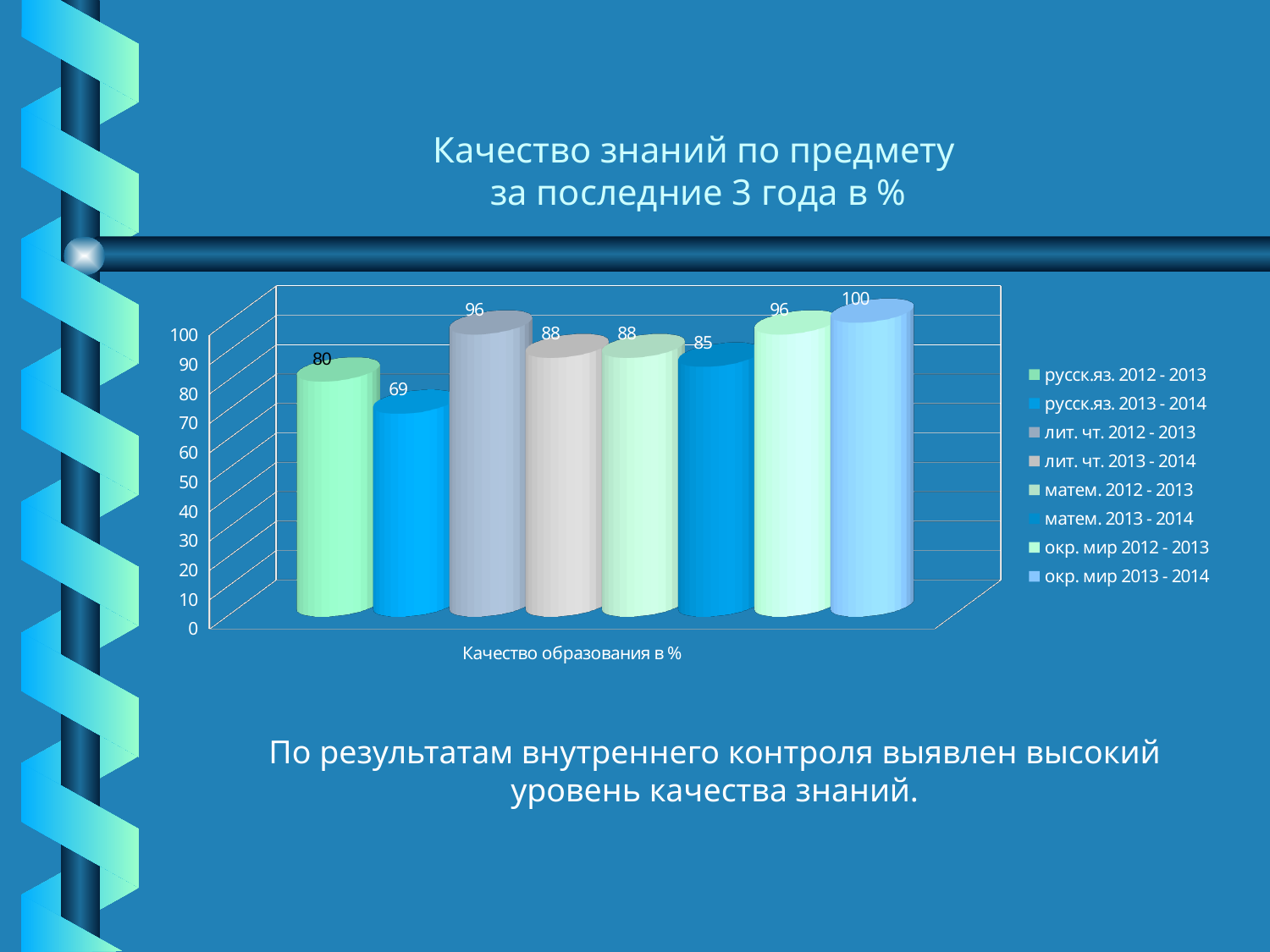
What is the value for окр. мир 2013 - 2014? 100 Which is larger, the value for лит. чт. 2012 - 2013 or лит. чт. 2013 - 2014? лит. чт. 2012 - 2013 What is the difference between the values for русск.яз. 2012 - 2013 and русск.яз. 2013 - 2014? 11 What is the value for русск.яз. 2013 - 2014? 69 What is the value for русск.яз. 2012 - 2013? 80 What kind of chart is shown on the slide? bar chart How many series does the legend list? 8 Which series has the lowest value? русск.яз. 2013 - 2014 Which series has the highest value? окр. мир 2013 - 2014 What is the value for лит. чт. 2012 - 2013? 96 What is the value for матем. 2013 - 2014? 85 What is the category label shown below the bars? Качество образования в %